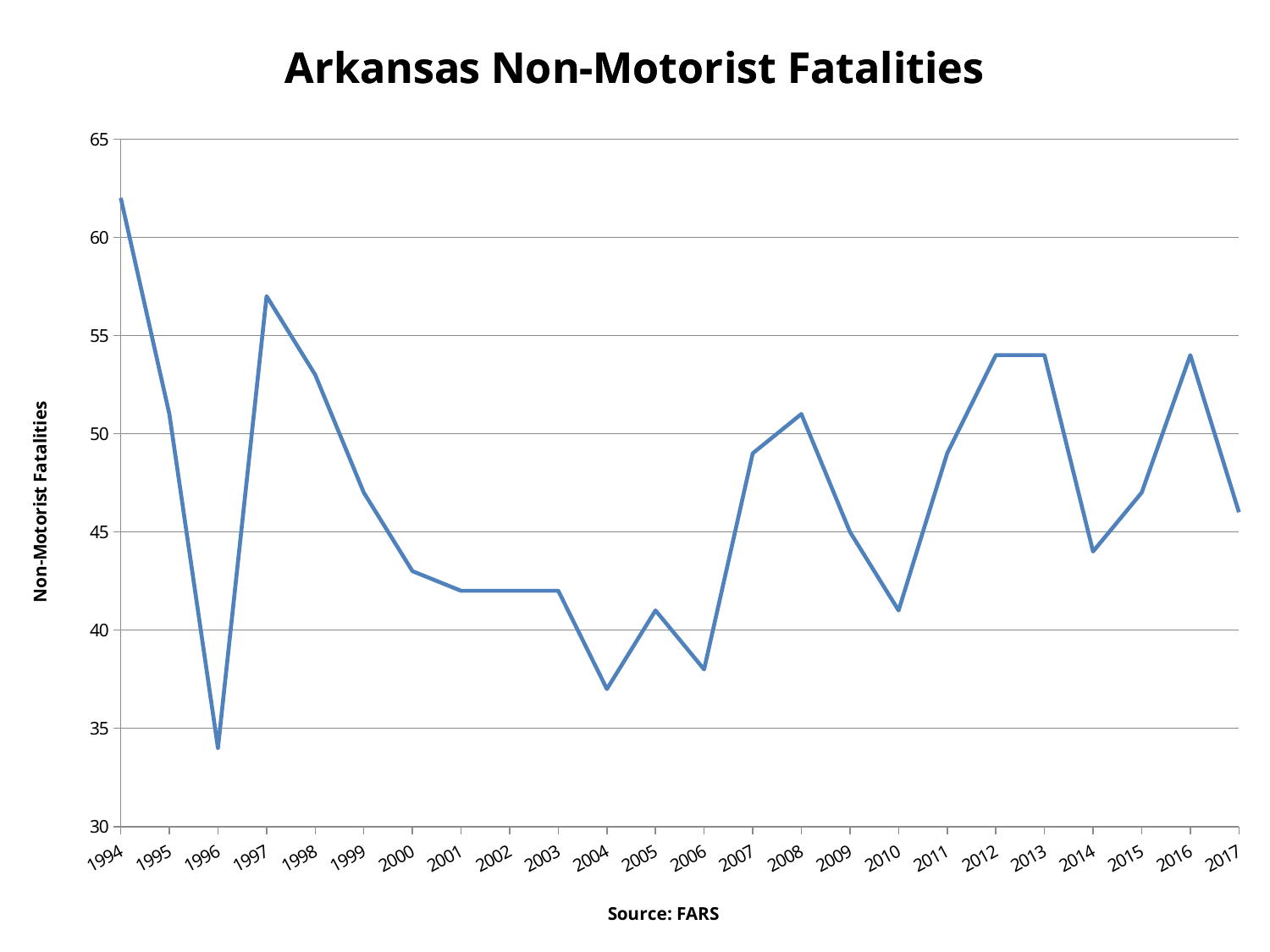
Is the value for 1994 greater or less than 60? greater Which year has the lowest number of non-motorist fatalities? 1996 Is the value for 1996 greater or less than 35? less Which year has the highest number of non-motorist fatalities? 1994 Is the value for 2004 greater or less than 40? less What is the label on the vertical axis of the chart? Non-Motorist Fatalities How many years are plotted on the x axis? 24 Do the values rise or fall from 1994 to 1996? fall What type of chart is shown on the slide? line chart What is the title of the chart? Arkansas Non-Motorist Fatalities Which year has a higher value, 1997 or 1998? 1997